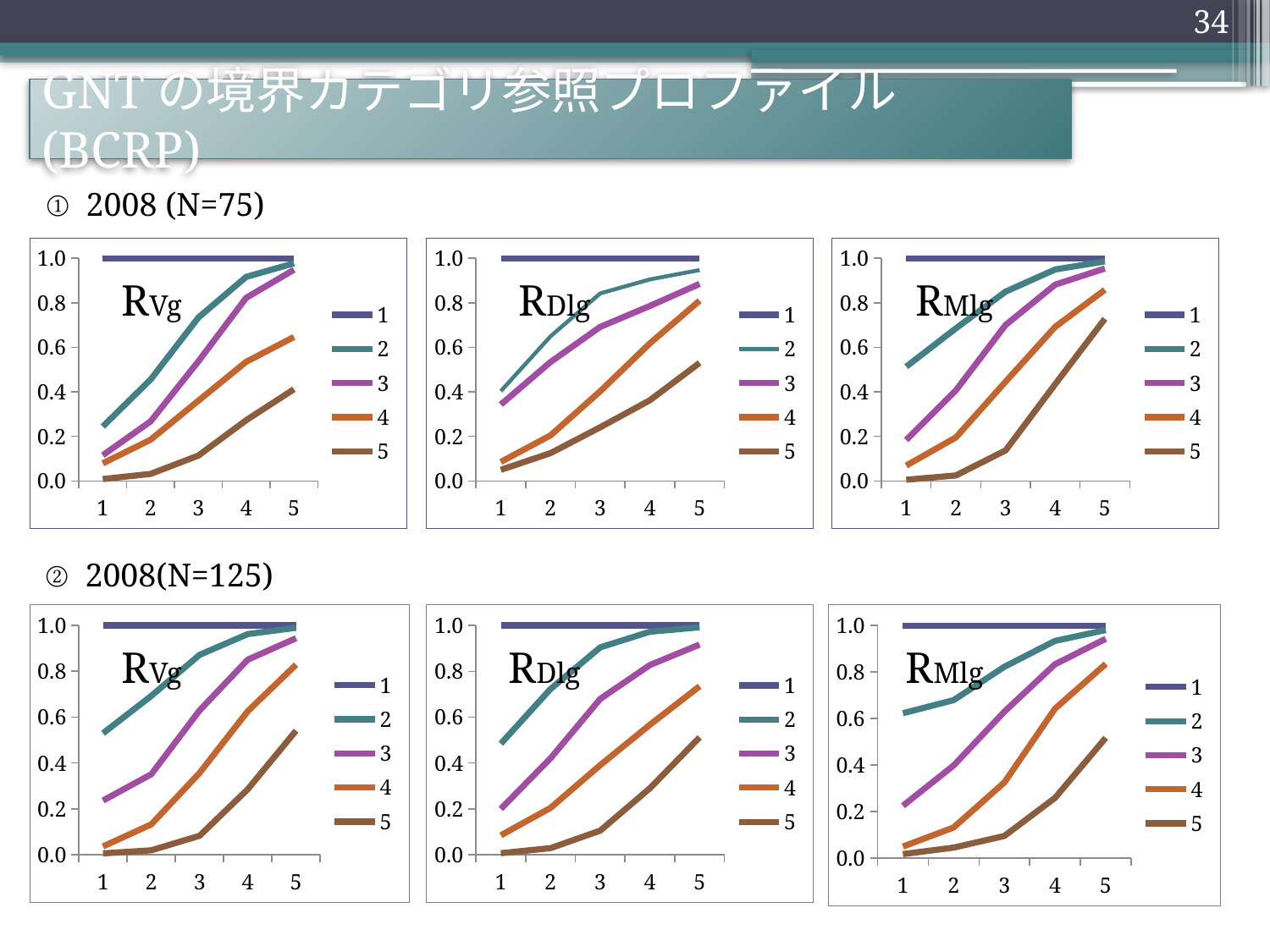
In the top-right RMlg chart under ① 2008 (N=75), which series has the lowest value at x = 1? 5 In the top-middle RDlg chart under ① 2008 (N=75), what is the value of series 1 at x = 3? 1.0 What kind of chart is the top-left chart labelled RVg under ① 2008 (N=75)? line chart In the top-middle RDlg chart under ① 2008 (N=75), is the value of series 2 at x = 1 greater or less than 0.2? greater How many series does the legend list in the top-left RVg chart under ① 2008 (N=75)? 5 In the top-left RVg chart under ① 2008 (N=75), which is larger at x = 3: series 2 or series 5? series 2 In the bottom-left RVg chart under ② 2008(N=125), is the value of series 2 at x = 1 greater or less than 0.4? greater In the bottom-right RMlg chart under ② 2008(N=125), does series 3 rise or fall as x increases from 1 to 5? rise In the top-left RVg chart under ① 2008 (N=75), is the value of series 5 at x = 5 greater or less than 0.2? greater How many points are plotted along the x axis in the bottom-middle RDlg chart under ② 2008(N=125)? 5 What label is printed inside the bottom-middle chart under ② 2008(N=125)? RDlg